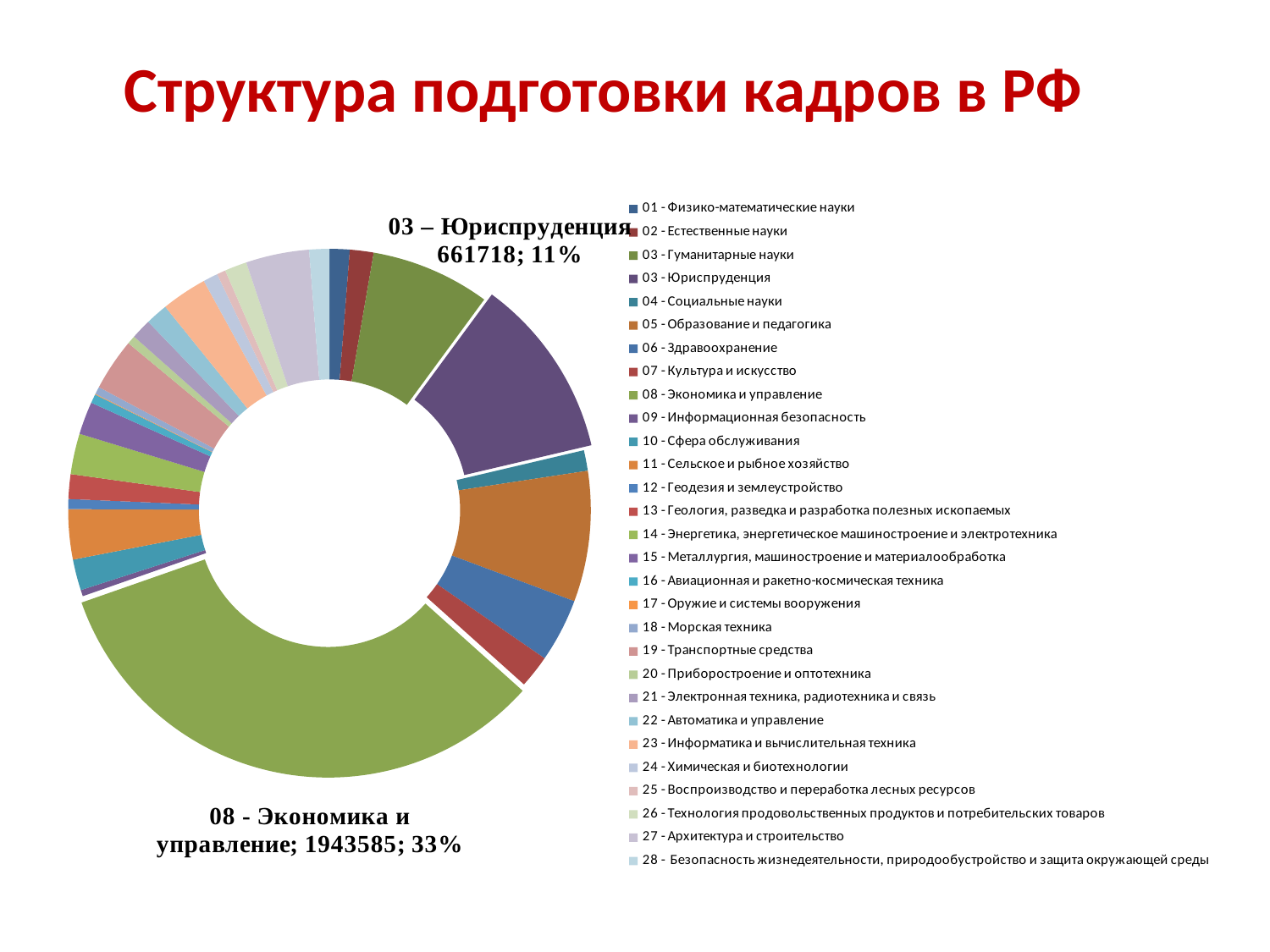
What value is shown for the category 08 - Экономика и управление? 1943585 By how many percentage points does the share of 08 - Экономика и управление exceed that of 03 – Юриспруденция? 22 What kind of chart is shown on the slide? doughnut chart What share of the whole does 08 - Экономика и управление represent? 33% Which category has the largest slice in the chart? 08 - Экономика и управление Which is larger: the slice for 03 – Юриспруденция or the slice for 03 - Гуманитарные науки? 03 – Юриспруденция What is the difference between the values for 08 - Экономика и управление and 03 – Юриспруденция? 1281867 What is the title of the slide? Структура подготовки кадров в РФ What value is shown for the category 03 – Юриспруденция? 661718 How many categories are listed in the legend? 29 What share of the whole does 03 – Юриспруденция represent? 11% Which is larger: the slice for 08 - Экономика и управление or the slice for 03 – Юриспруденция? 08 - Экономика и управление